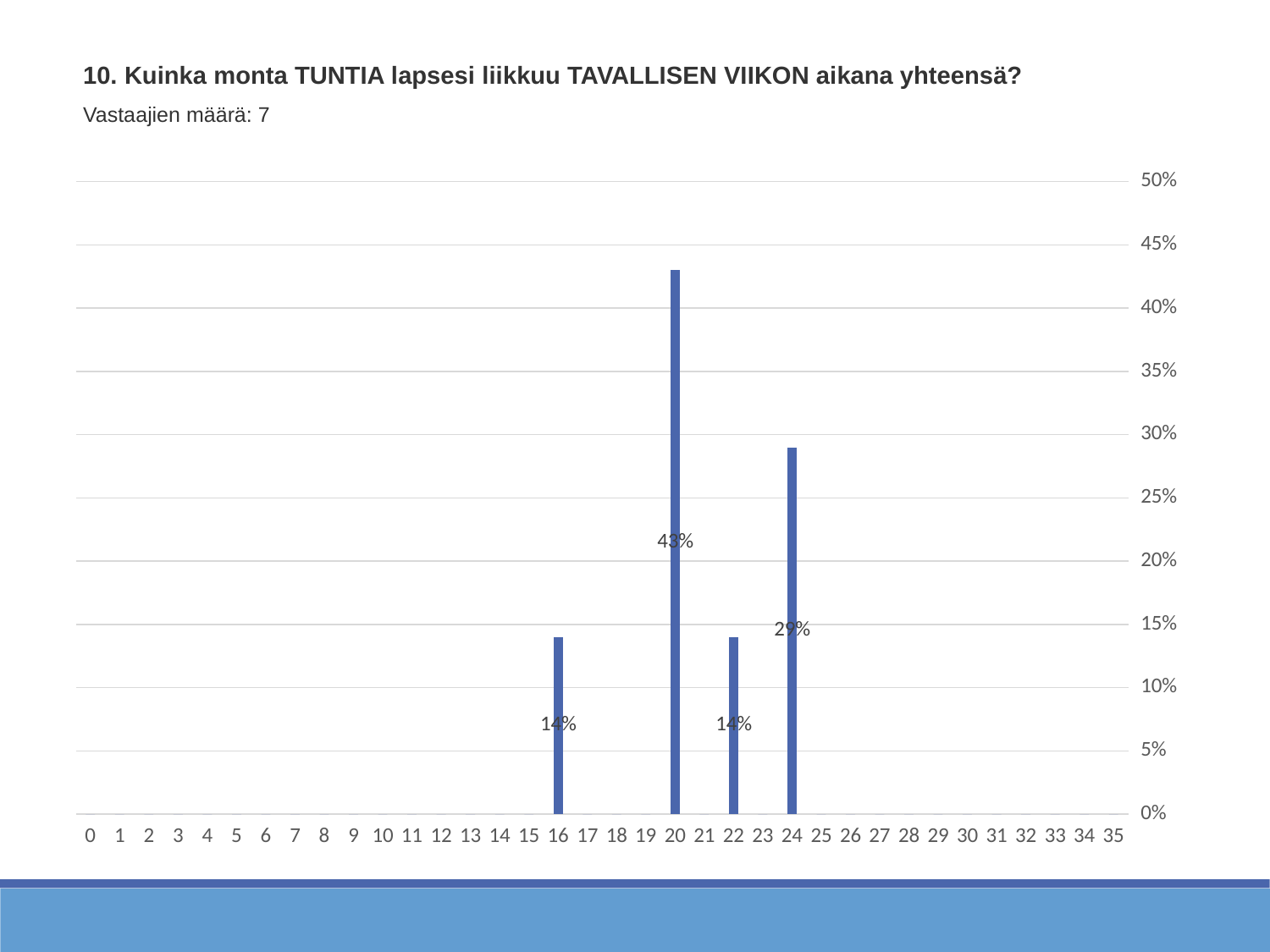
What is the value for category 24? 29% What is the value for category 16? 14% Is the value for category 24 greater or less than 30%? less How many categories have a non-zero bar? 4 Which is larger, the value for category 24 or the value for category 22? 24 What is the difference between the values for categories 24 and 16? 15% Is the value for category 20 greater or less than 40%? greater What is the value for category 22? 14% What kind of chart is shown on the slide? bar chart What is the value for category 20? 43% Which category has the highest value? 20 What is the difference between the values for categories 20 and 24? 14%